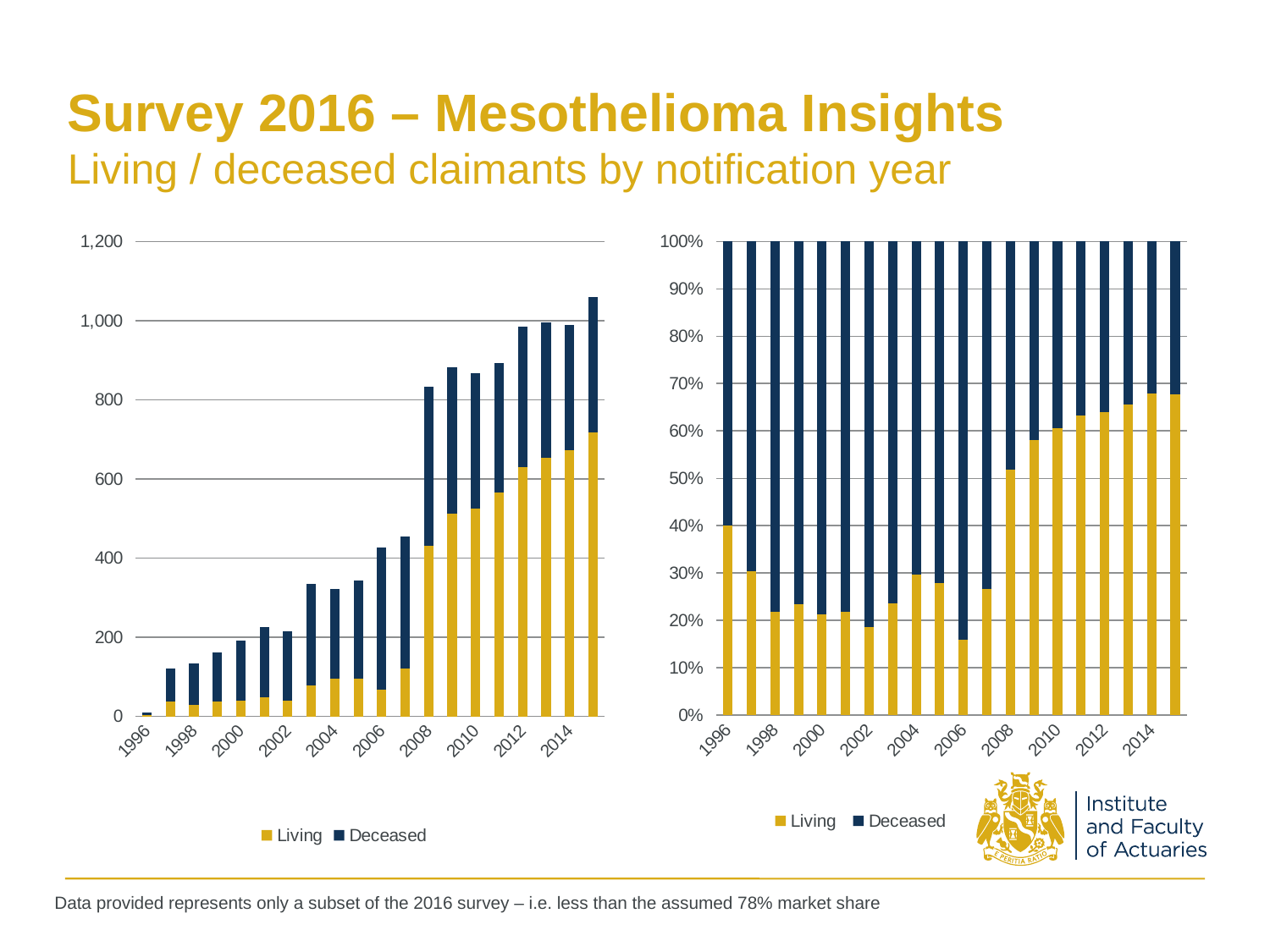
In the left chart, is the total number of claimants for 2015 greater or less than 1,000? greater In the right chart, is the Living share for 2015 greater or less than 60%? greater In the left chart, is the total number of claimants for 2008 greater or less than 800? greater In the left chart, do the total claimant counts generally rise or fall from 1996 to 2015? rise In the right chart, which is larger: the Living share for 2014 or the Living share for 2006? 2014 What kind of chart is the left chart on the slide? Stacked bar chart In the left chart, which notification year has the highest total number of claimants? 2015 How many series does the legend of the left chart list? 2 How many notification years (bars) are plotted in the left chart? 20 What are the two series named in the legend of the right chart? Living and Deceased